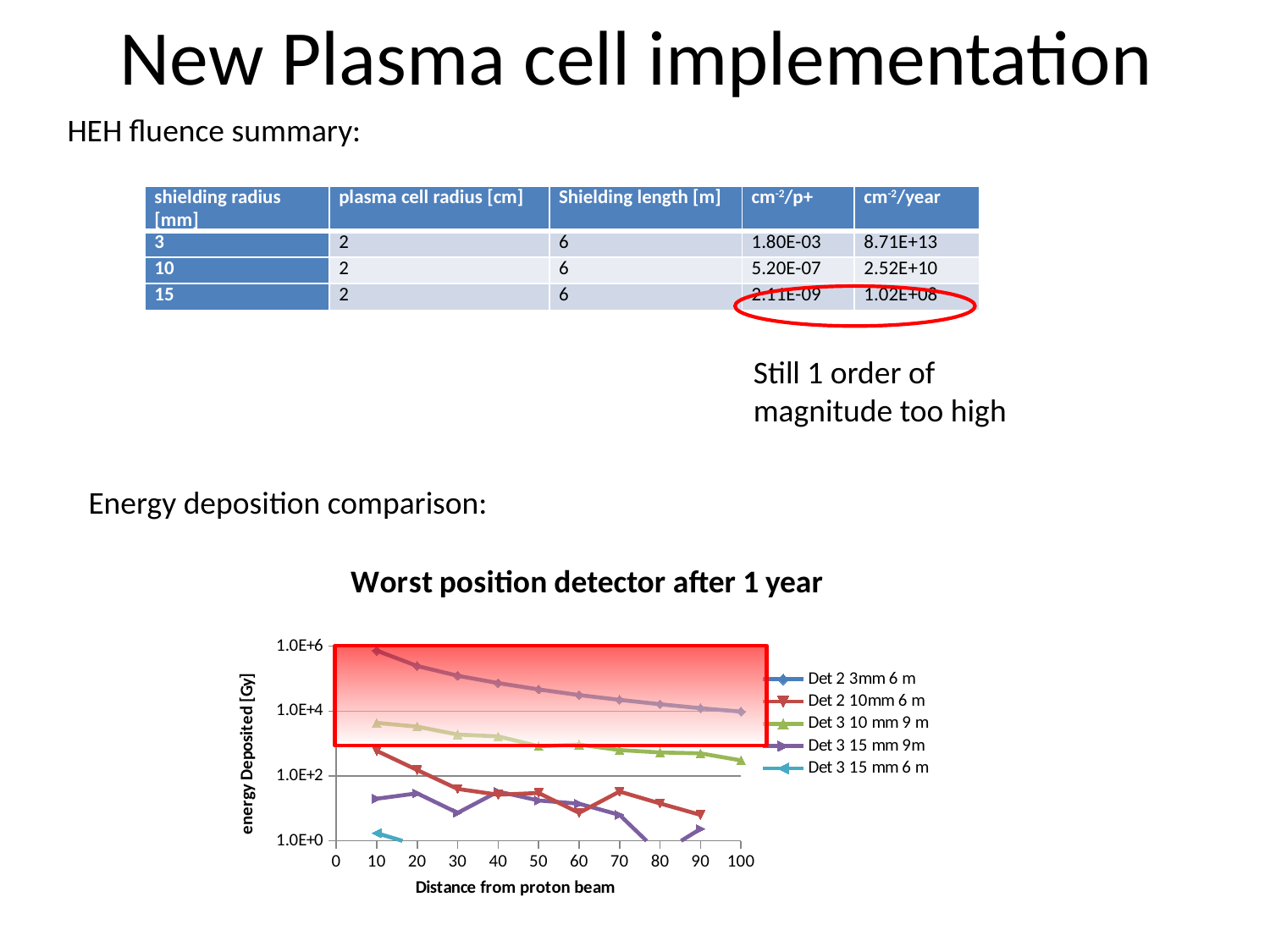
In the chart, is the value for Det 2 10mm 6 m at a distance of 90 greater or less than 1.0E+2? less What is the title of the chart on the slide? Worst position detector after 1 year How many series does the legend of the "Worst position detector after 1 year" chart list? 5 Which series in the chart has the lowest energy deposited values? Det 3 15 mm 6 m In the chart, does the energy deposited for Det 2 3mm 6 m rise or fall as the distance from the proton beam increases? fall What is the label of the y axis of the chart? energy Deposited [Gy] In the chart, is the value for Det 2 10mm 6 m at a distance of 10 greater or less than 1.0E+2? greater In the chart, at a distance of 10, which series has the larger energy deposited: Det 2 3mm 6 m or Det 3 10 mm 9 m? Det 2 3mm 6 m In the chart, is the value for Det 2 3mm 6 m at a distance of 50 greater or less than 1.0E+4? greater What kind of chart is "Worst position detector after 1 year"? line chart Which series in the chart has the highest energy deposited values across the distance range? Det 2 3mm 6 m